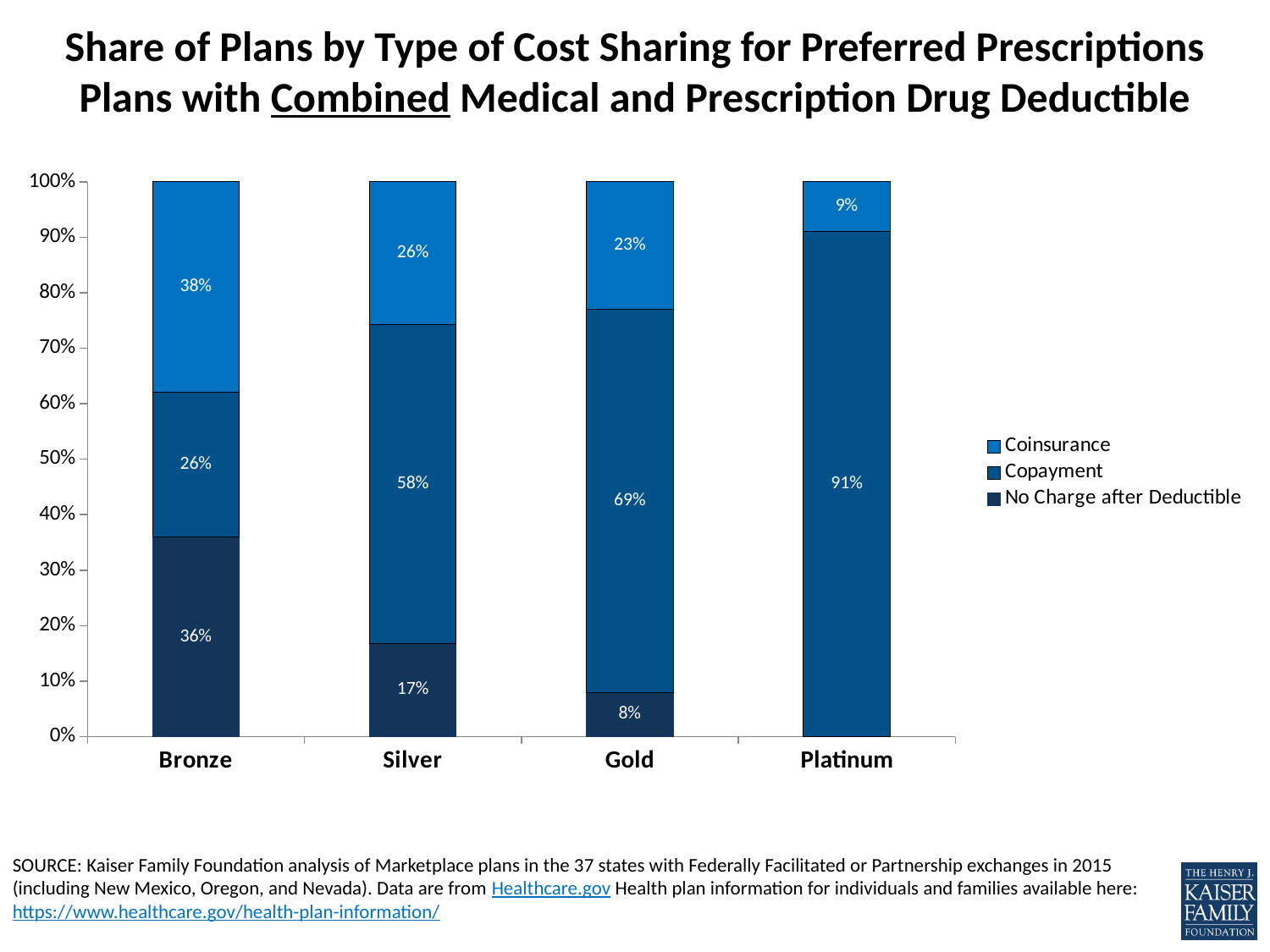
What is the No Charge after Deductible share for Silver plans? 17% How many series does the legend list? 3 Does the Copayment share rise or fall moving from Bronze to Platinum along the x axis? Rise What kind of chart is shown on the slide? Stacked bar chart What is the Coinsurance share for Platinum plans? 9% Which plan type has the highest Copayment share? Platinum Which is larger: the No Charge after Deductible share for Bronze or for Gold? Bronze What is the difference between the Copayment share for Silver and the Copayment share for Bronze? 32 percentage points What is the Copayment share for Gold plans? 69% Which plan type has the lowest Coinsurance share? Platinum How many plan types are shown on the x axis? 4 What share of Bronze plans use coinsurance for preferred prescriptions? 38%